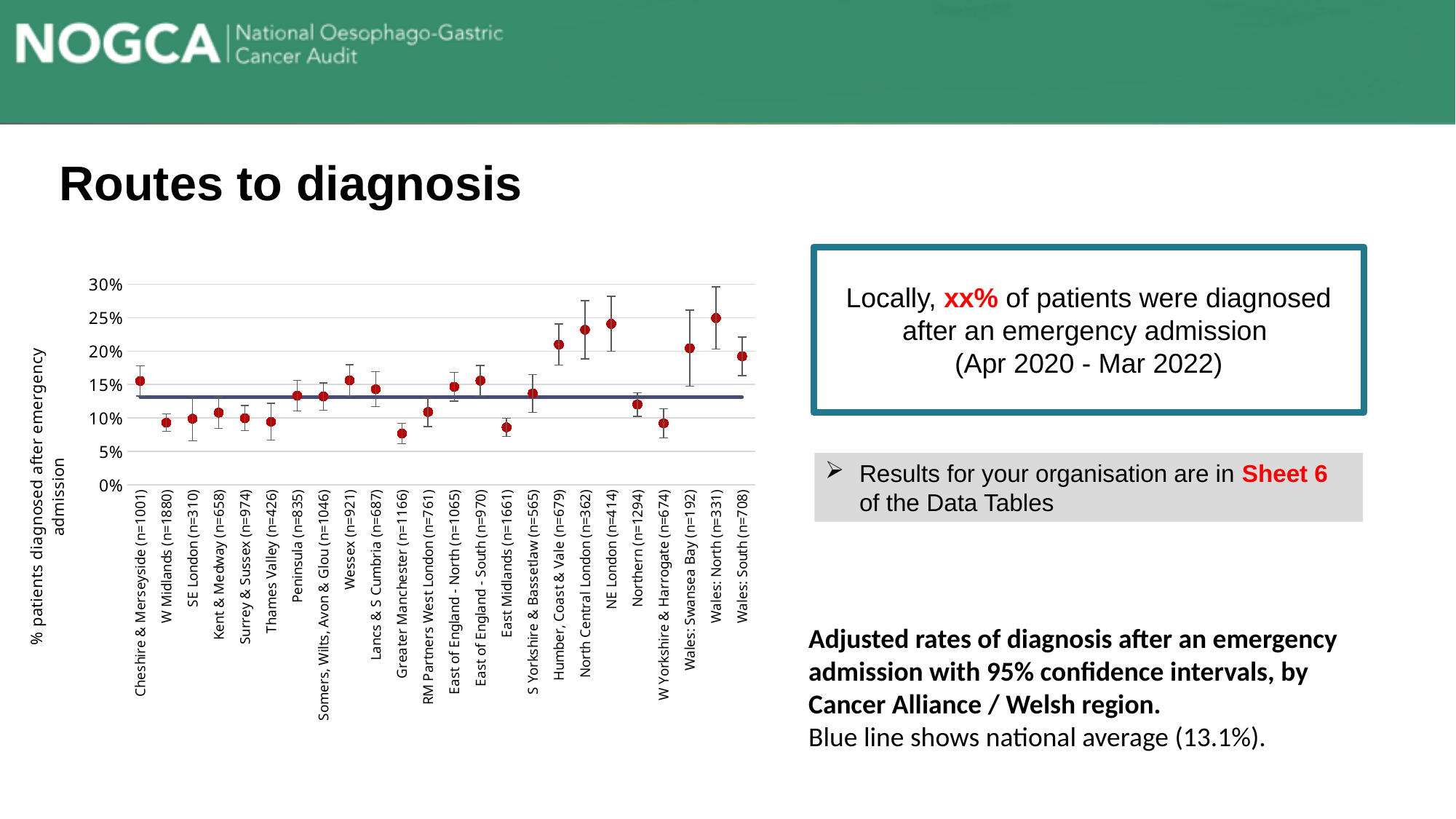
Is the value for Wales: North greater or less than 20%? greater What national average does the blue line on the chart represent? 13.1% Is the value for Greater Manchester greater or less than 10%? less Is the value for East Midlands greater or less than 10%? less Which has the higher rate, Wales: Swansea Bay or W Yorkshire & Harrogate? Wales: Swansea Bay What kind of chart is shown on the slide? Scatter chart with error bars Which region has the lowest adjusted rate of diagnosis after an emergency admission? Greater Manchester What is the sample size (n) shown for East Midlands on the x axis? 1661 How many Cancer Alliances / Welsh regions are plotted on the x axis? 24 Which has the higher rate, North Central London or Greater Manchester? North Central London